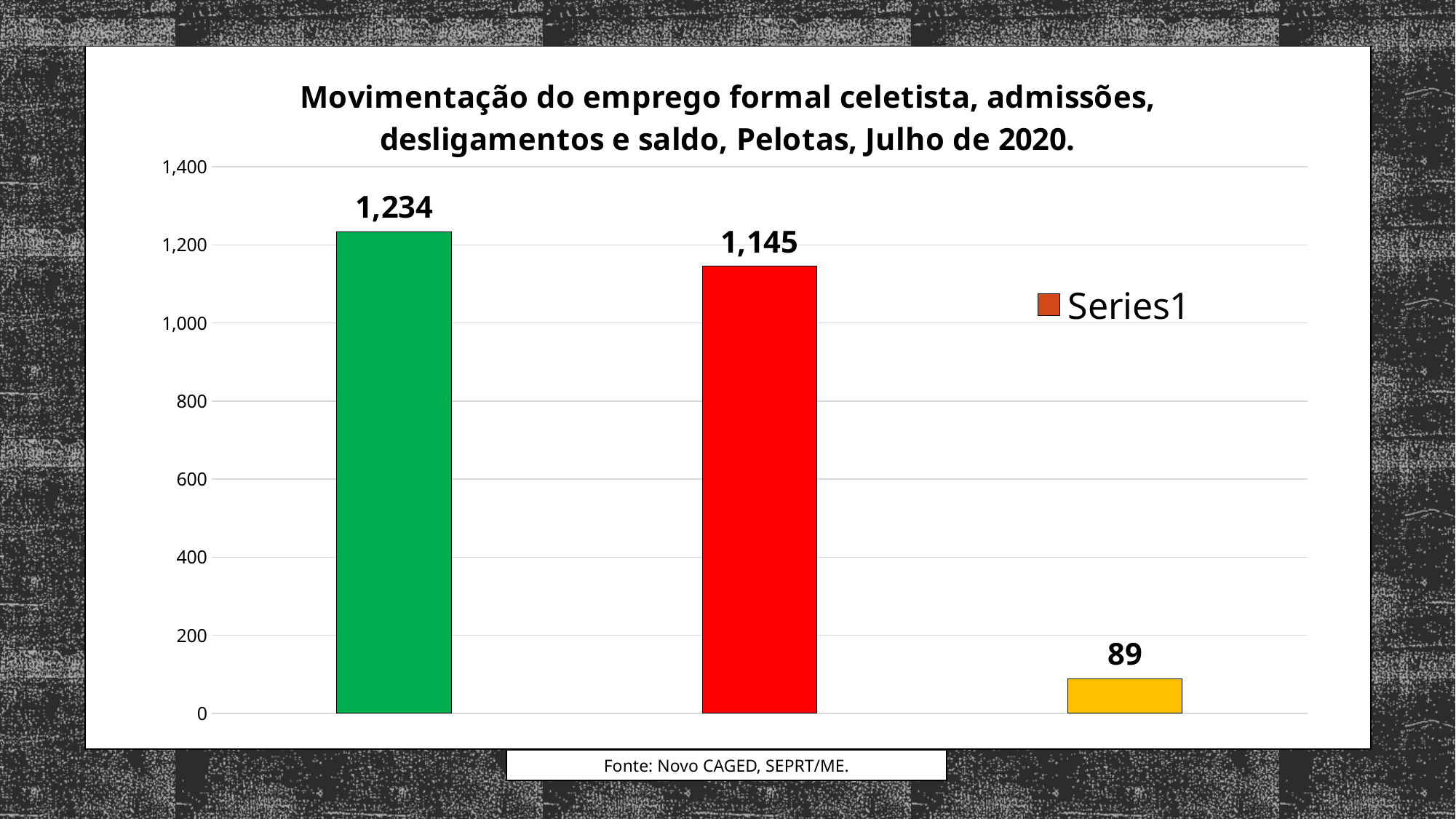
What kind of chart is shown on the slide? bar chart Is the value of the yellow bar greater or less than 200? less What is the difference between the red bar (1,145) and the yellow bar (89)? 1,056 What is the value of the green bar on the left? 1,234 How many bars are plotted in the chart? 3 What is the value of the red bar in the middle? 1,145 Which bar has the highest value: the green, red or yellow one? green Which bar has the lowest value: the green, red or yellow one? yellow How many series does the legend list? 1 What is the value of the yellow bar on the right? 89 Which is larger, the value of the green bar or the value of the red bar? green bar What is the difference between the green bar (1,234) and the red bar (1,145)? 89